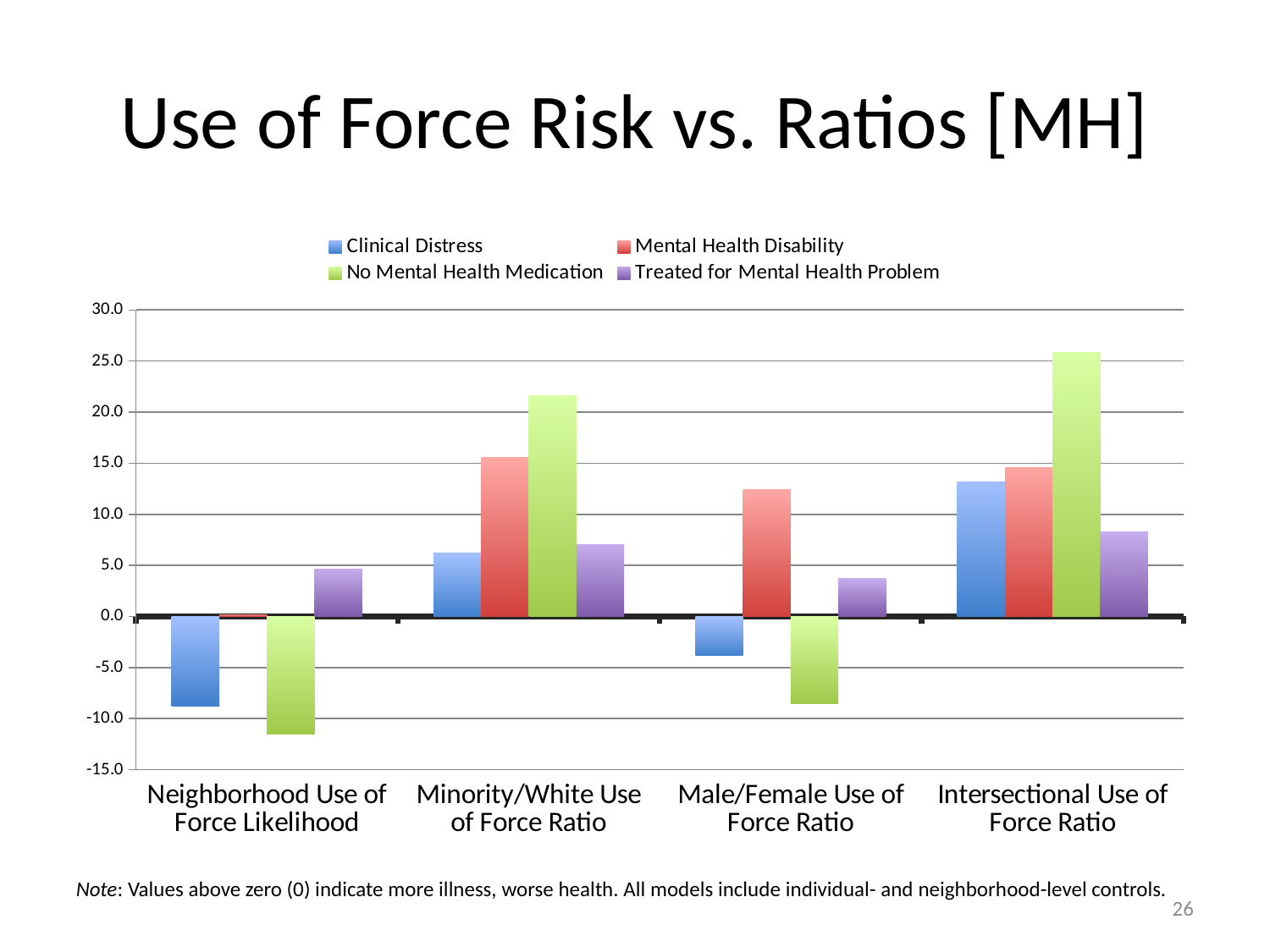
How many categories are shown along the x axis? 4 Is the value for No Mental Health Medication in Intersectional Use of Force Ratio greater or less than 25.0? greater Which category has the lowest value for No Mental Health Medication? Neighborhood Use of Force Likelihood Is the value for Clinical Distress in Neighborhood Use of Force Likelihood greater or less than -5.0? less Which category has the highest value for No Mental Health Medication? Intersectional Use of Force Ratio In Minority/White Use of Force Ratio, which is larger: No Mental Health Medication or Mental Health Disability? No Mental Health Medication Is the value for Mental Health Disability in Minority/White Use of Force Ratio greater or less than 10.0? greater Which series has the highest value in Male/Female Use of Force Ratio? Mental Health Disability How many series does the legend list? 4 What is the title of the chart? Use of Force Risk vs. Ratios [MH] In Intersectional Use of Force Ratio, which is larger: Clinical Distress or Treated for Mental Health Problem? Clinical Distress What kind of chart is shown on the slide? bar chart